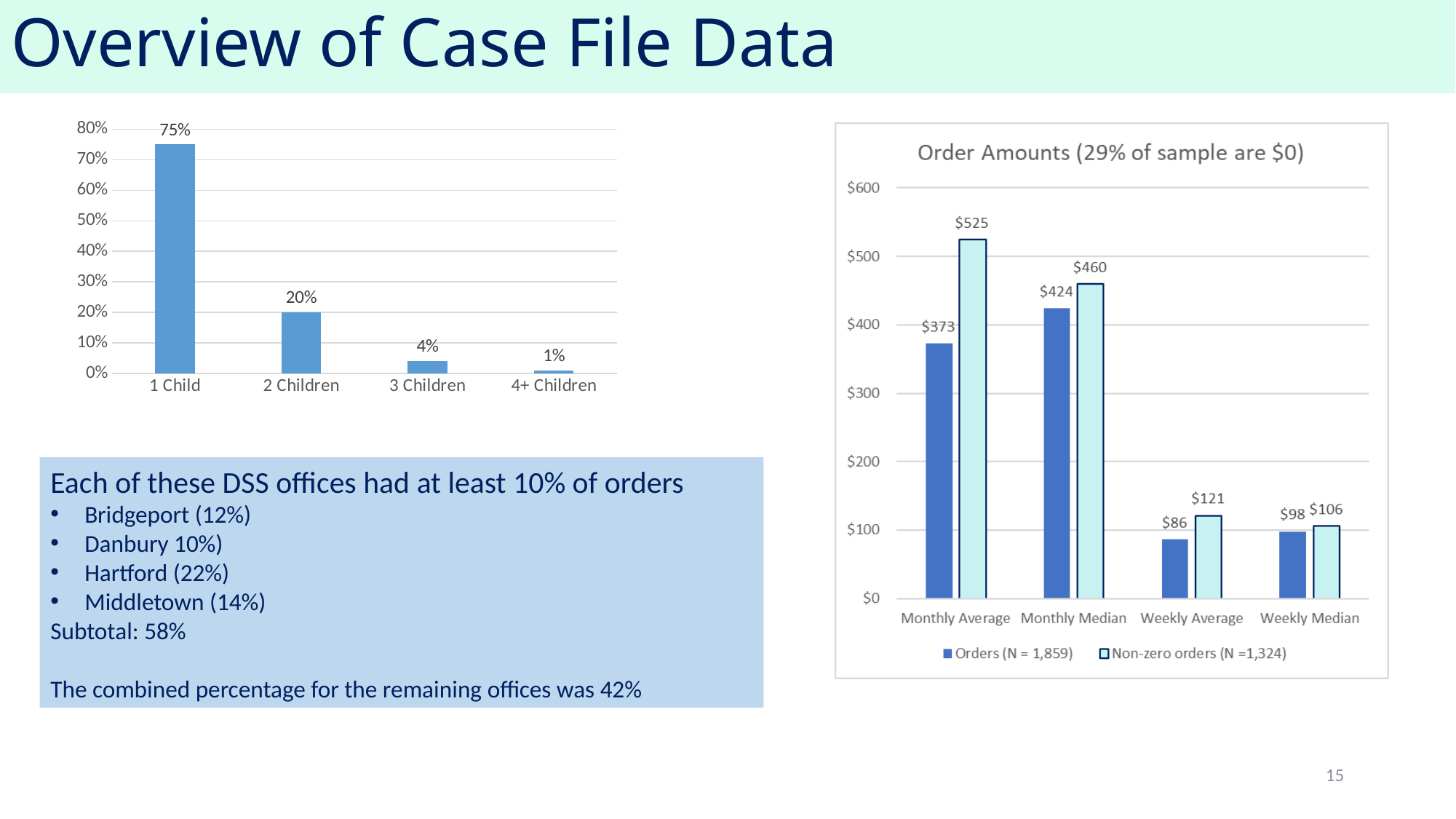
In the 'Order Amounts' chart, which is larger for Weekly Median: Orders (N = 1,859) or Non-zero orders (N =1,324)? Non-zero orders (N =1,324) What kind of chart is the 'Order Amounts' chart? Bar chart In the chart on the left (number of children), what is the difference between the values for 1 Child and 2 Children? 55% In the 'Order Amounts' chart, how many series does the legend list? 2 In the chart on the left (number of children), what is the value for 3 Children? 4% In the chart on the left (number of children), what is the value for 1 Child? 75% In the 'Order Amounts' chart, what is the Monthly Median value for Orders (N = 1,859)? $424 In the 'Order Amounts' chart, what is the difference between the Non-zero orders and Orders values for Monthly Average? $152 In the 'Order Amounts' chart, what is the Weekly Average value for Non-zero orders (N =1,324)? $121 In the chart on the left (number of children), how many categories are shown on the x axis? 4 In the 'Order Amounts' chart, which category has the highest value for Non-zero orders (N =1,324)? Monthly Average In the chart on the left (number of children), which category has the lowest value? 4+ Children